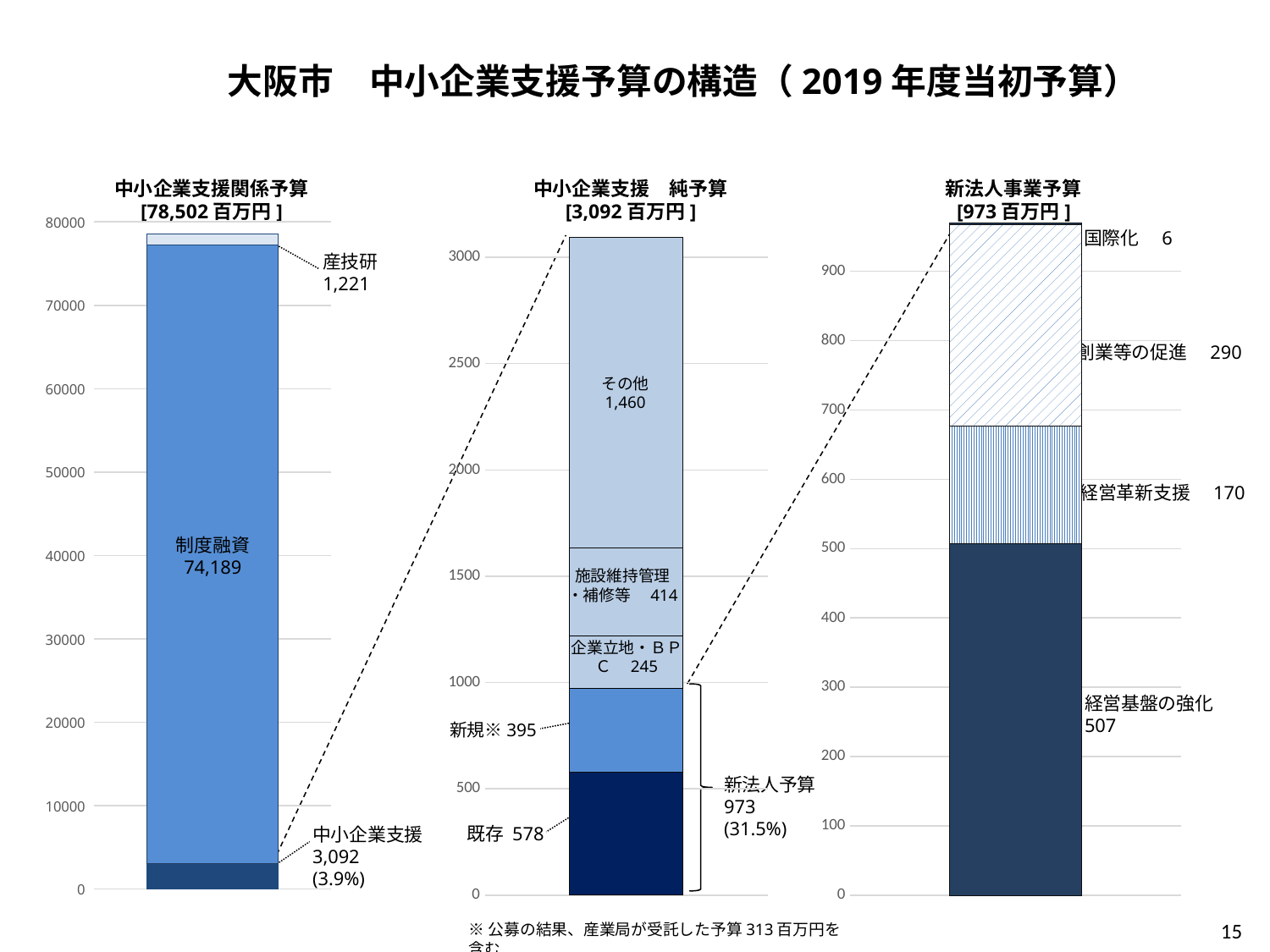
In the middle chart (中小企業支援 純予算), what is the value for その他? 1,460 In the middle chart (中小企業支援 純予算), which segment has the smallest value? 企業立地・BPC In the left chart (中小企業支援関係予算), what is the value for 制度融資? 74,189 In the middle chart (中小企業支援 純予算), what is the difference between 既存 and 新規? 183 In the middle chart (中小企業支援 純予算), what is the total of the stacked bar as shown in its title? 3,092 百万円 In the left chart (中小企業支援関係予算), what is the value for 産技研? 1,221 In the left chart (中小企業支援関係予算), what percentage share is shown for 中小企業支援? 3.9% In the right chart (新法人事業予算), which segment has the largest value? 経営基盤の強化 In the right chart (新法人事業予算), what is the difference between 創業等の促進 and 経営革新支援? 120 What kind of chart is used in the middle chart (中小企業支援 純予算)? Stacked bar chart In the right chart (新法人事業予算), how many segments make up the stacked bar? 4 In the right chart (新法人事業予算), what is the value for 経営基盤の強化? 507